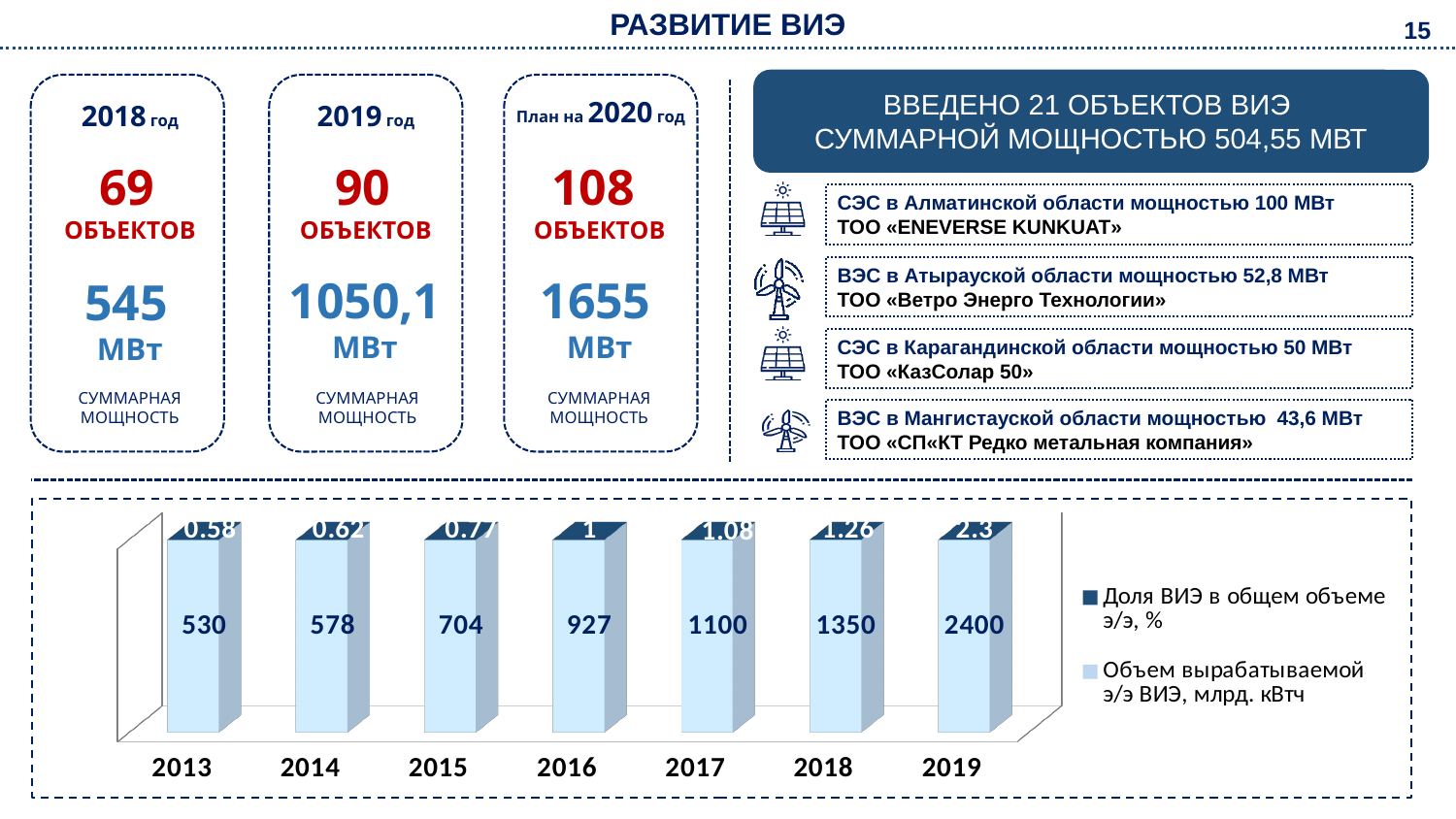
How many years are shown on the x axis of the chart? 7 Do the values of 'Объем вырабатываемой э/э ВИЭ, млрд. кВтч' rise or fall from 2013 to 2019? rise What is the value of 'Доля ВИЭ в общем объеме э/э, %' for 2019? 2.3 Which year has the highest value of 'Объем вырабатываемой э/э ВИЭ, млрд. кВтч'? 2019 What is the value of 'Объем вырабатываемой э/э ВИЭ, млрд. кВтч' for 2016? 927 What is the difference in 'Объем вырабатываемой э/э ВИЭ, млрд. кВтч' between 2019 and 2018? 1050 What is the value of 'Объем вырабатываемой э/э ВИЭ, млрд. кВтч' for 2013? 530 Which is larger: 'Объем вырабатываемой э/э ВИЭ, млрд. кВтч' in 2015 or in 2014? 2015 What kind of chart is shown at the bottom of the slide? bar chart What is the value of 'Доля ВИЭ в общем объеме э/э, %' for 2017? 1.08 How many series does the chart legend list? 2 Which year has the lowest value of 'Доля ВИЭ в общем объеме э/э, %'? 2013